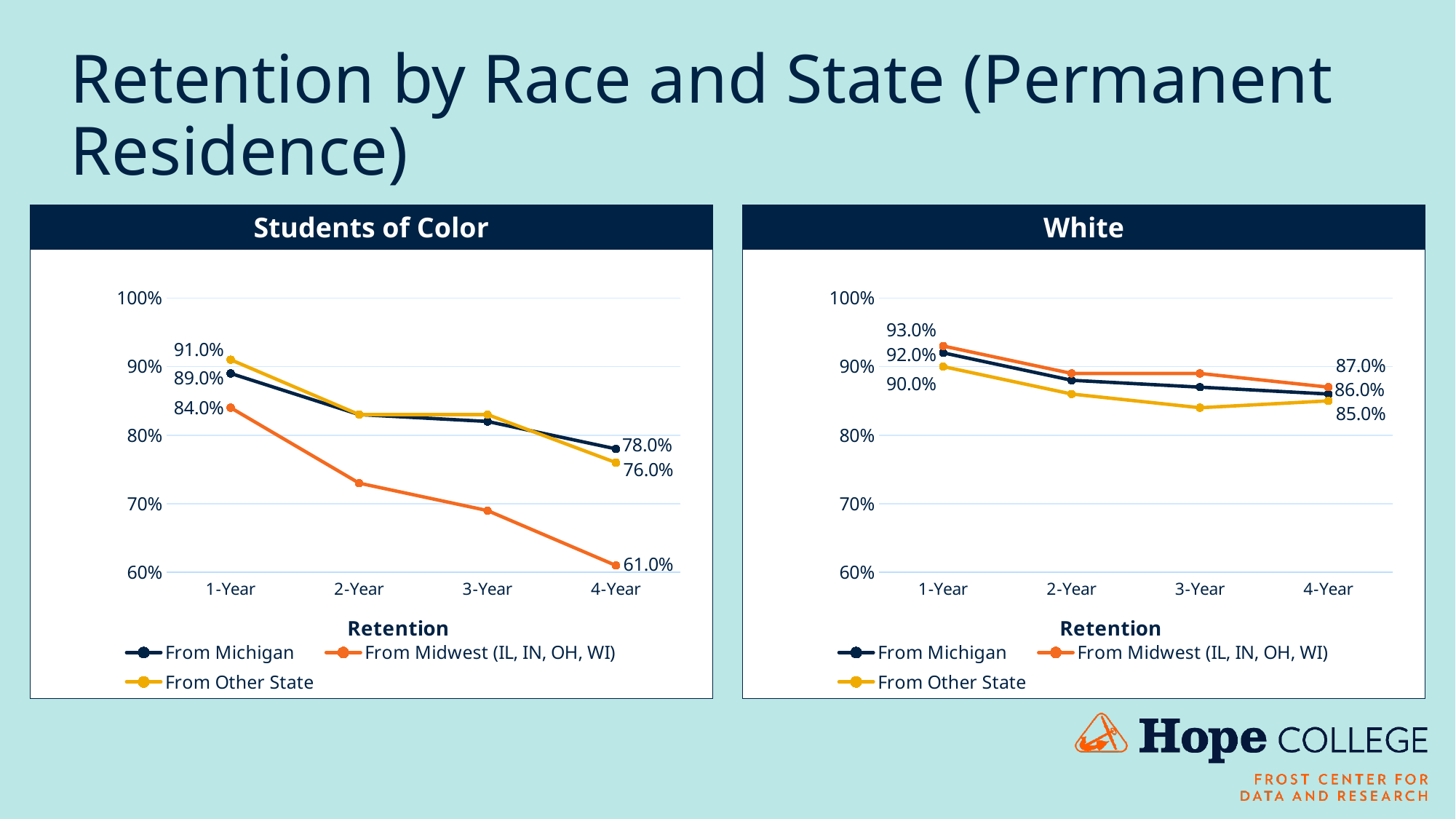
In the Students of Color chart, what is the difference between the 4-Year retention for From Michigan and From Other State? 2.0% In the White chart, what is the 1-Year retention for students From Michigan? 92.0% In the White chart, which series has the highest 1-Year retention? From Midwest (IL, IN, OH, WI) In the Students of Color chart, what is the 1-Year retention for students From Other State? 91.0% In the White chart, what is the 4-Year retention for students From Midwest (IL, IN, OH, WI)? 87.0% How many series does the legend of the White chart list? 3 In the Students of Color chart, which series has the lowest 4-Year retention? From Midwest (IL, IN, OH, WI) In the Students of Color chart, what is the difference between the 1-Year and 4-Year retention for From Midwest (IL, IN, OH, WI)? 23.0% In the White chart, is the 2-Year retention for From Other State greater or less than 80%? greater In the Students of Color chart, what is the 4-Year retention for students From Midwest (IL, IN, OH, WI)? 61.0% In the Students of Color chart, does the retention for From Midwest (IL, IN, OH, WI) rise or fall from 1-Year to 4-Year? fall